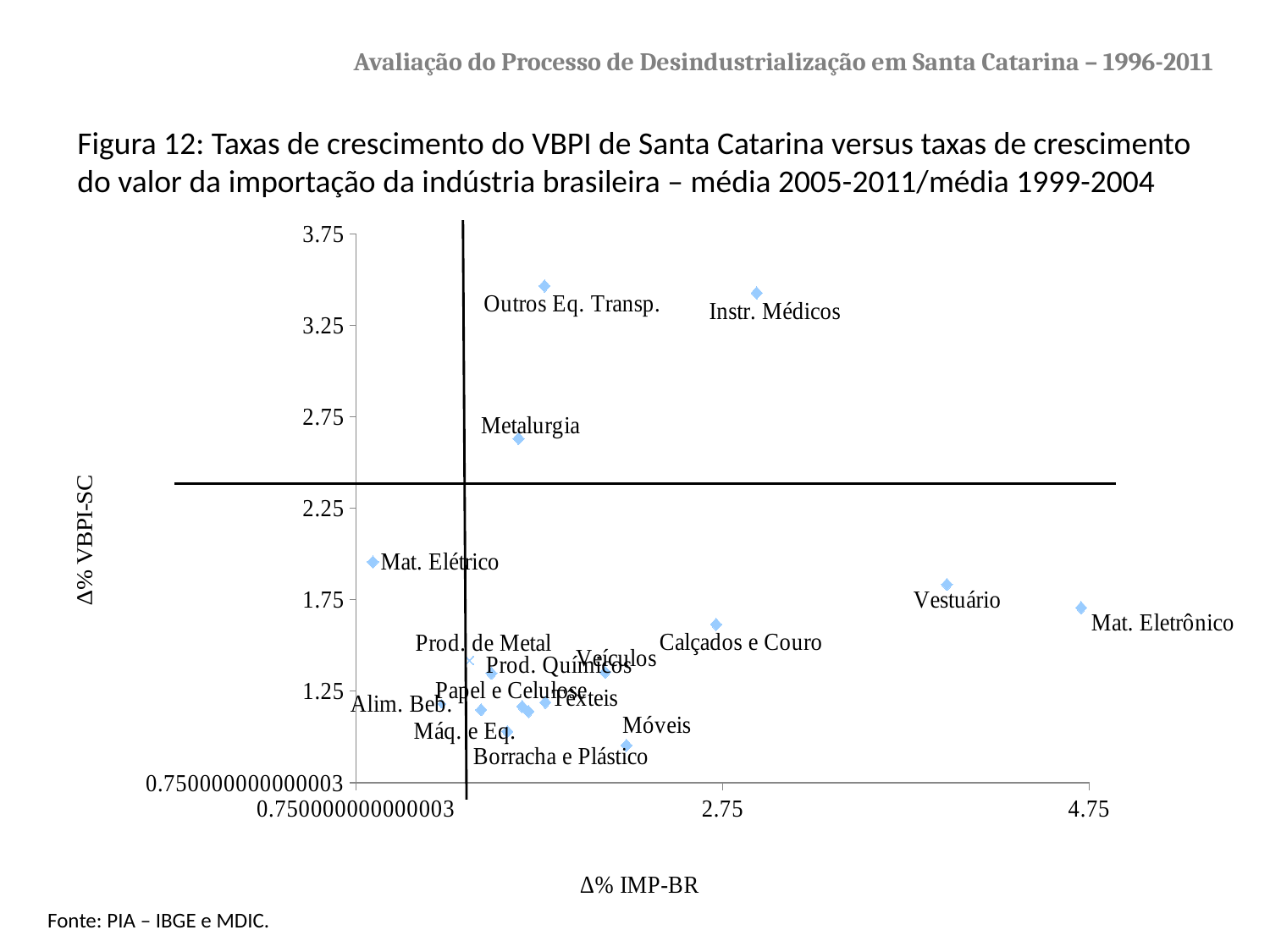
Is the Δ% VBPI-SC value for Mat. Elétrico greater or less than 1.75? greater What kind of chart is shown on the slide? scatter chart Is the Δ% VBPI-SC value for Outros Eq. Transp. greater or less than 3.25? greater Is the Δ% VBPI-SC value for Móveis greater or less than 1.25? less Which industry has the lowest Δ% IMP-BR value? Mat. Elétrico What is the label of the horizontal axis? Δ% IMP-BR Which industry has the lowest Δ% VBPI-SC value? Móveis What is the label of the vertical axis? Δ% VBPI-SC Which industry has the highest Δ% IMP-BR value? Mat. Eletrônico Which has a higher Δ% VBPI-SC value, Metalurgia or Mat. Elétrico? Metalurgia